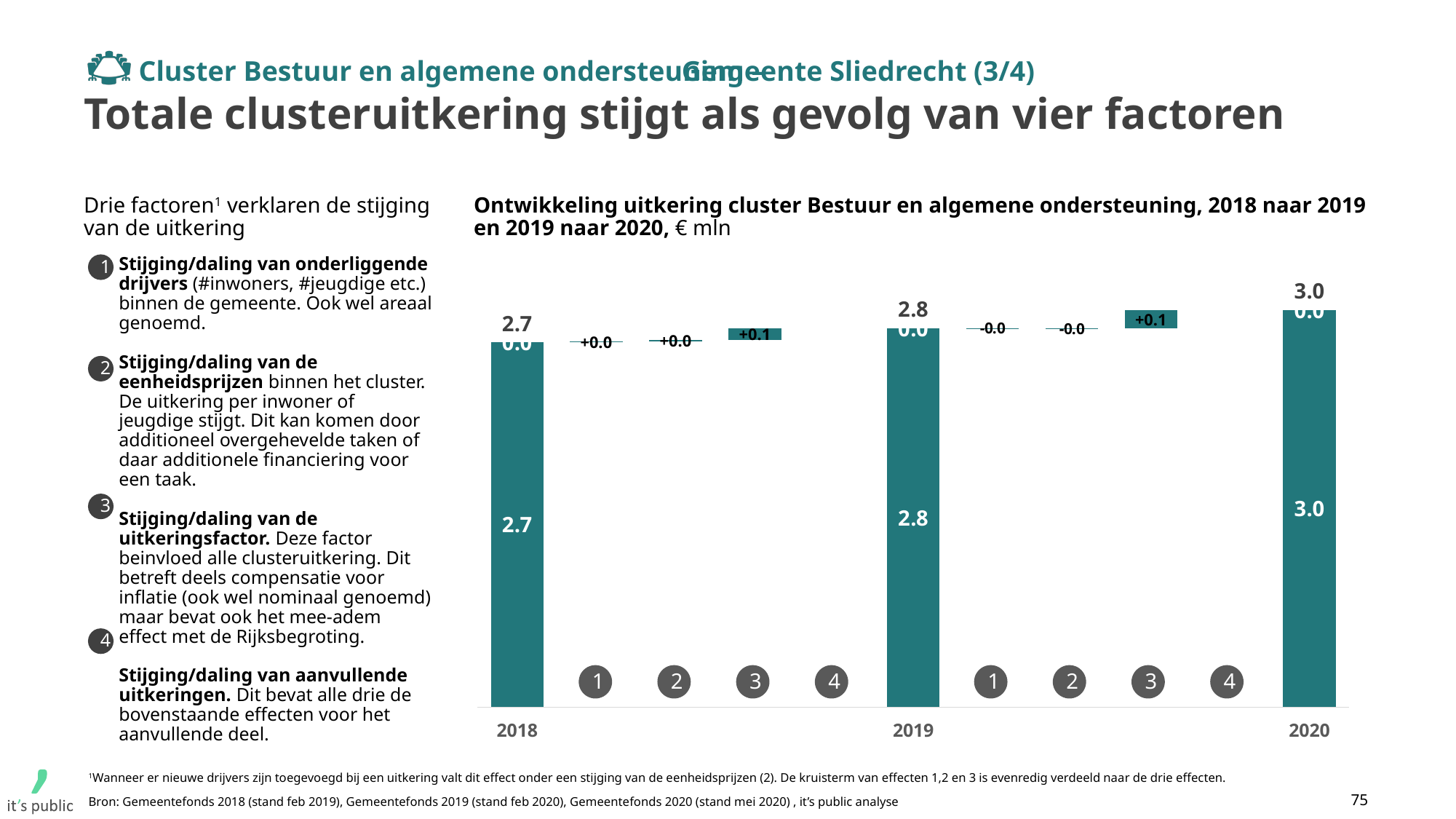
Is the total for 2019 larger or smaller than the total for 2020? smaller What is the difference between the 2020 total and the 2018 total? 0.3 What is the value of factor 3 (uitkeringsfactor) between 2019 and 2020? +0.1 What is the total uitkering for 2019 in the chart? 2.8 Which year has the lowest total uitkering? 2018 Which year has the highest total uitkering? 2020 What is the total uitkering for 2018 in the chart? 2.7 In what unit are the values in the chart expressed? € mln What is the total uitkering for 2020 in the chart? 3.0 Does the total uitkering rise or fall from 2018 to 2020? rise What is the value of factor 3 (uitkeringsfactor) between 2018 and 2019? +0.1 What is the value of factor 1 between 2018 and 2019? +0.0